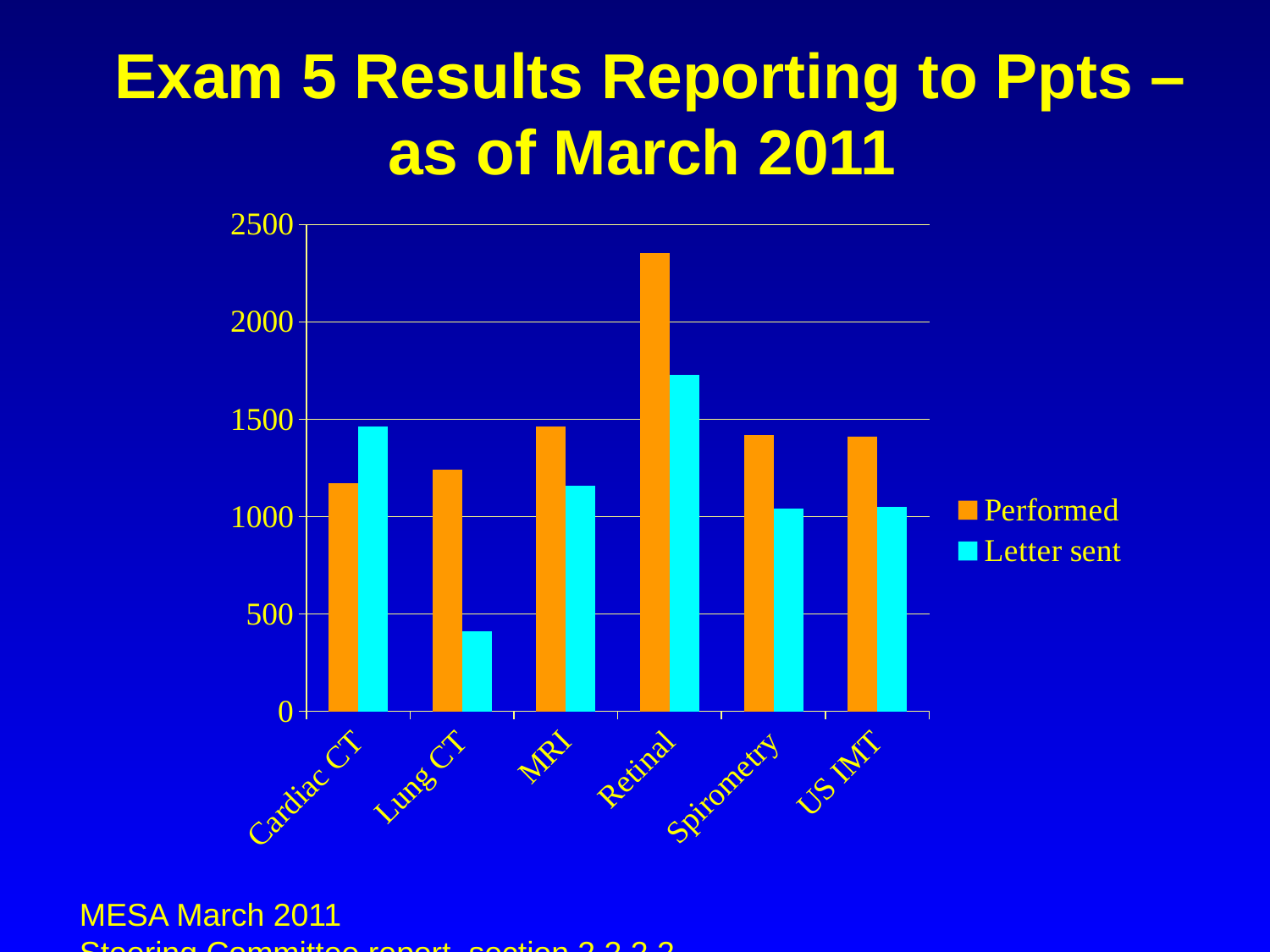
Which category has the lowest Letter sent value? Lung CT How many exam categories are shown on the x axis? 6 How many series does the legend list? 2 Which category has the highest Performed value? Retinal Is the Performed value for Retinal greater or less than 2000? greater What kind of chart is shown on the slide? bar chart Is the Letter sent value for Retinal greater or less than 1500? greater Is the Letter sent value for Lung CT greater or less than 500? less Which colour represents the Performed series in the legend? orange Which category has the highest Letter sent value? Retinal For Lung CT, which is larger: Performed or Letter sent? Performed For Cardiac CT, which is larger: Performed or Letter sent? Letter sent